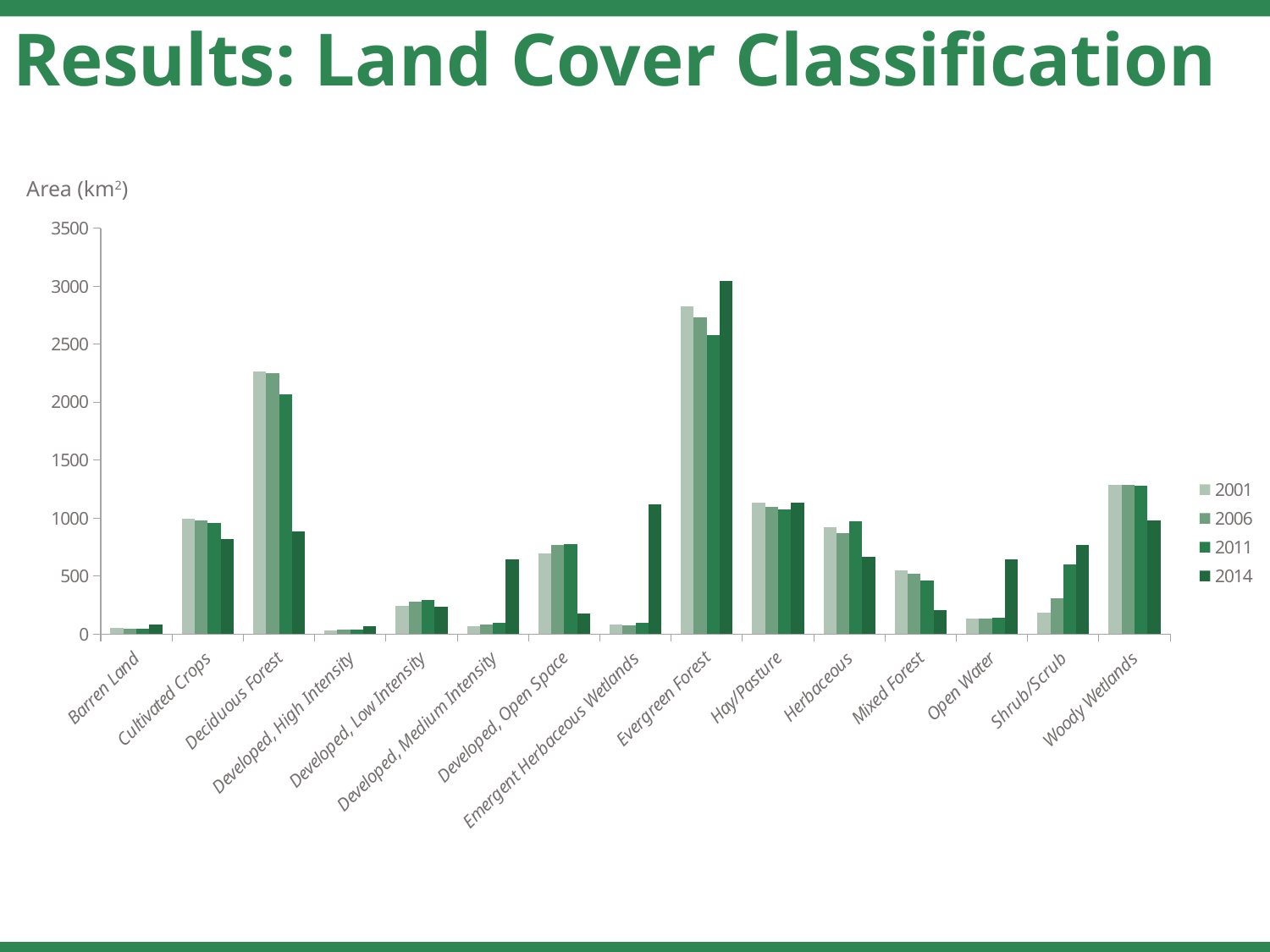
Which land cover category has the highest area values? Evergreen Forest How many land cover categories are shown on the x axis? 15 Is the 2014 value for Mixed Forest greater or less than 500? less How many series does the legend list? 4 For Shrub/Scrub, which is larger: the 2001 value or the 2014 value? 2014 Is the 2001 value for Deciduous Forest greater or less than 2000? greater What kind of chart is shown on the slide? Bar chart For Deciduous Forest, which is larger: the 2001 value or the 2014 value? 2001 What is the label of the vertical axis? Area (km²) Do the values for Deciduous Forest rise or fall from 2001 to 2014? fall Is the 2014 value for Emergent Herbaceous Wetlands greater or less than 1000? greater